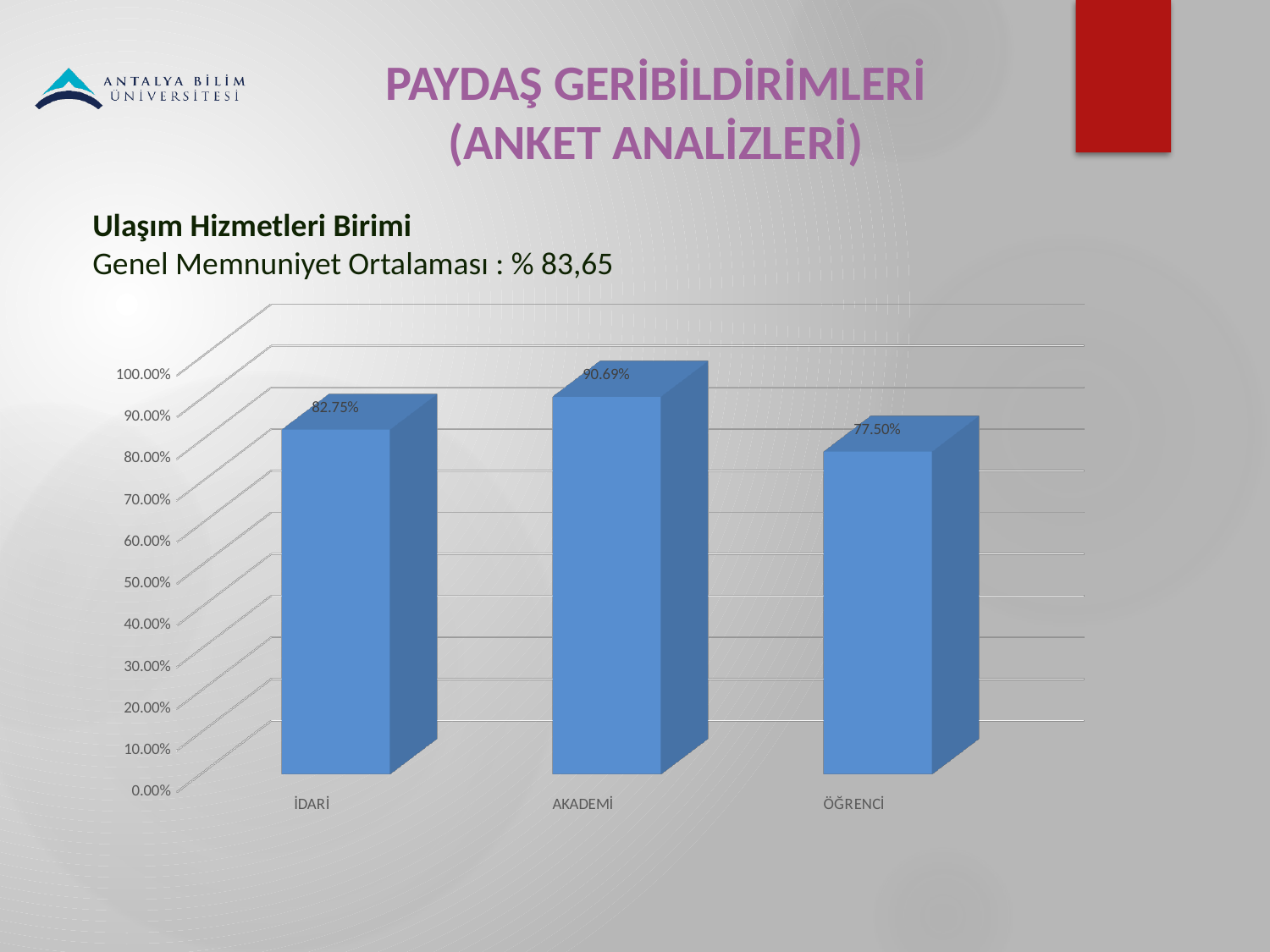
What kind of chart is shown on the slide? bar chart What is the value for İDARİ? 82.75% What is the value for ÖĞRENCİ? 77.50% What is the difference between the values for AKADEMİ and İDARİ? 7.94% What is the value for AKADEMİ? 90.69% What is the general satisfaction average (Genel Memnuniyet Ortalaması) stated above the chart? % 83,65 Which category has the lowest value? ÖĞRENCİ Is the value for AKADEMİ greater or less than 90.00%? greater Which category has the highest value? AKADEMİ Which is larger, the value for İDARİ or the value for ÖĞRENCİ? İDARİ How many categories are shown on the x axis? 3 What is the difference between the values for İDARİ and ÖĞRENCİ? 5.25%